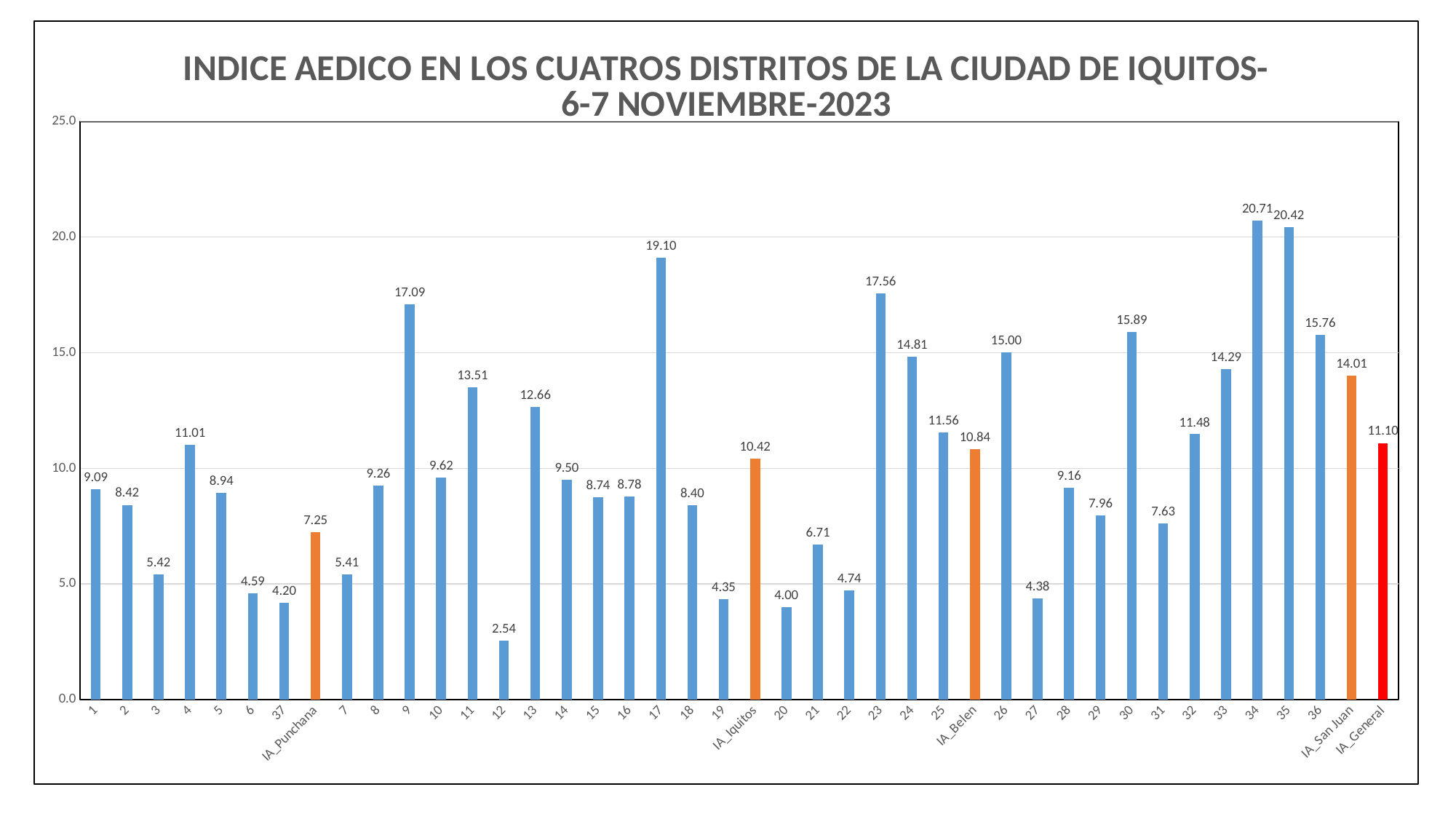
What is the value for IA_Punchana? 7.25 What type of chart is shown on the slide? bar chart What is the difference between the values for IA_San Juan and IA_Belen? 3.17 Is the value for category 23 greater or less than 15.0? greater Which is larger, the value for IA_Iquitos or the value for IA_Belen? IA_Belen What is the difference between the values for category 34 and category 35? 0.29 What is the title of the chart? INDICE AEDICO EN LOS CUATROS DISTRITOS DE LA CIUDAD DE IQUITOS- 6-7 NOVIEMBRE-2023 Which category has the lowest value? 12 How many bars are plotted in the chart? 42 What is the value for IA_General? 11.10 What is the value for category 17? 19.10 Which category has the highest value? 34